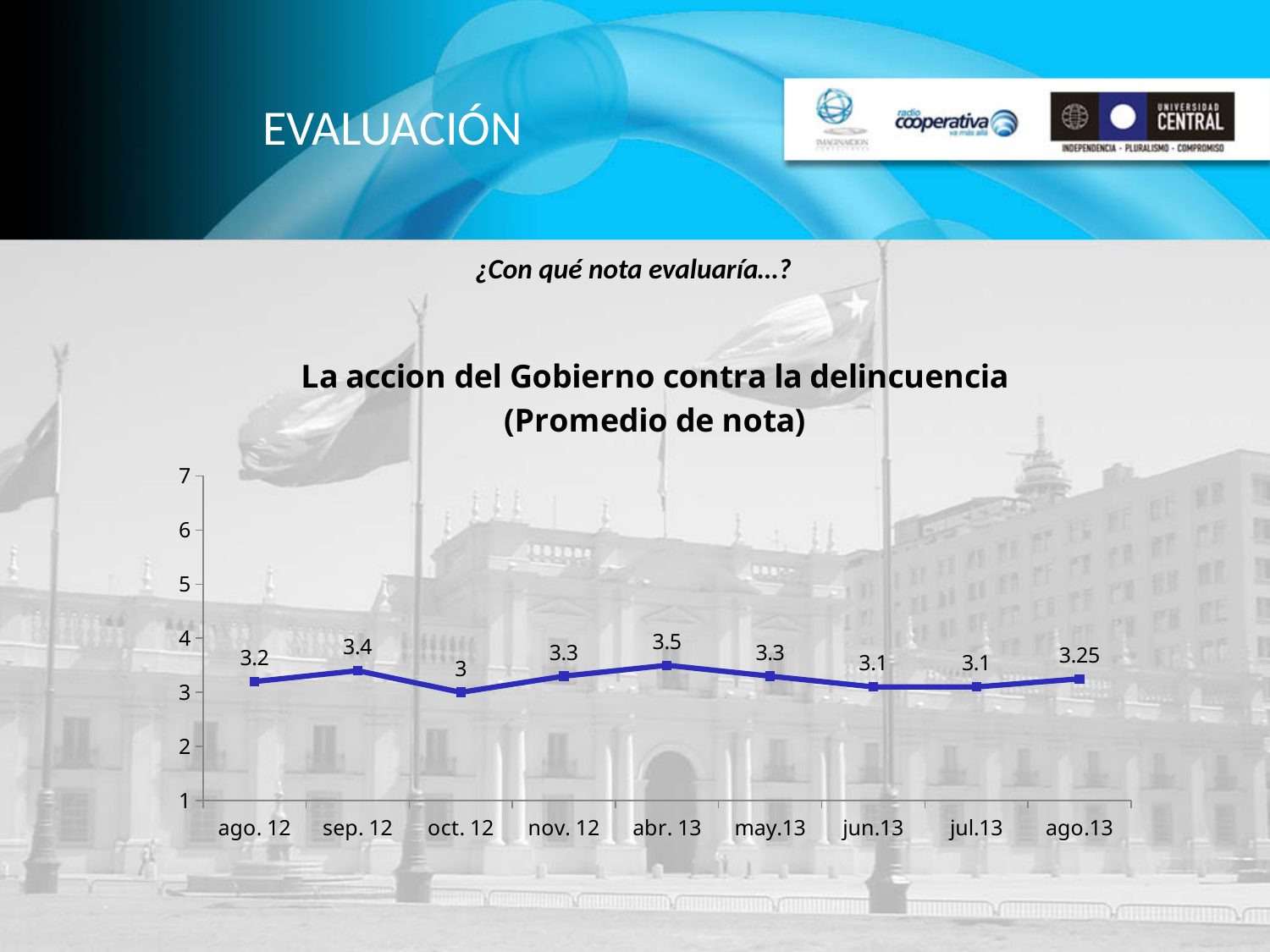
What is the title of the chart? La accion del Gobierno contra la delincuencia (Promedio de nota) Which month has the lowest value? oct. 12 What is the value for oct. 12? 3 What is the value for abr. 13? 3.5 How many months are plotted on the chart? 9 Which is larger, the value for sep. 12 or the value for ago. 12? sep. 12 Which month has the highest value? abr. 13 Is the value for abr. 13 greater or less than 4? less What is the difference between the values for abr. 13 and oct. 12? 0.5 What is the difference between the values for ago.13 and jul.13? 0.15 What is the value for ago.13? 3.25 What kind of chart is shown? line chart